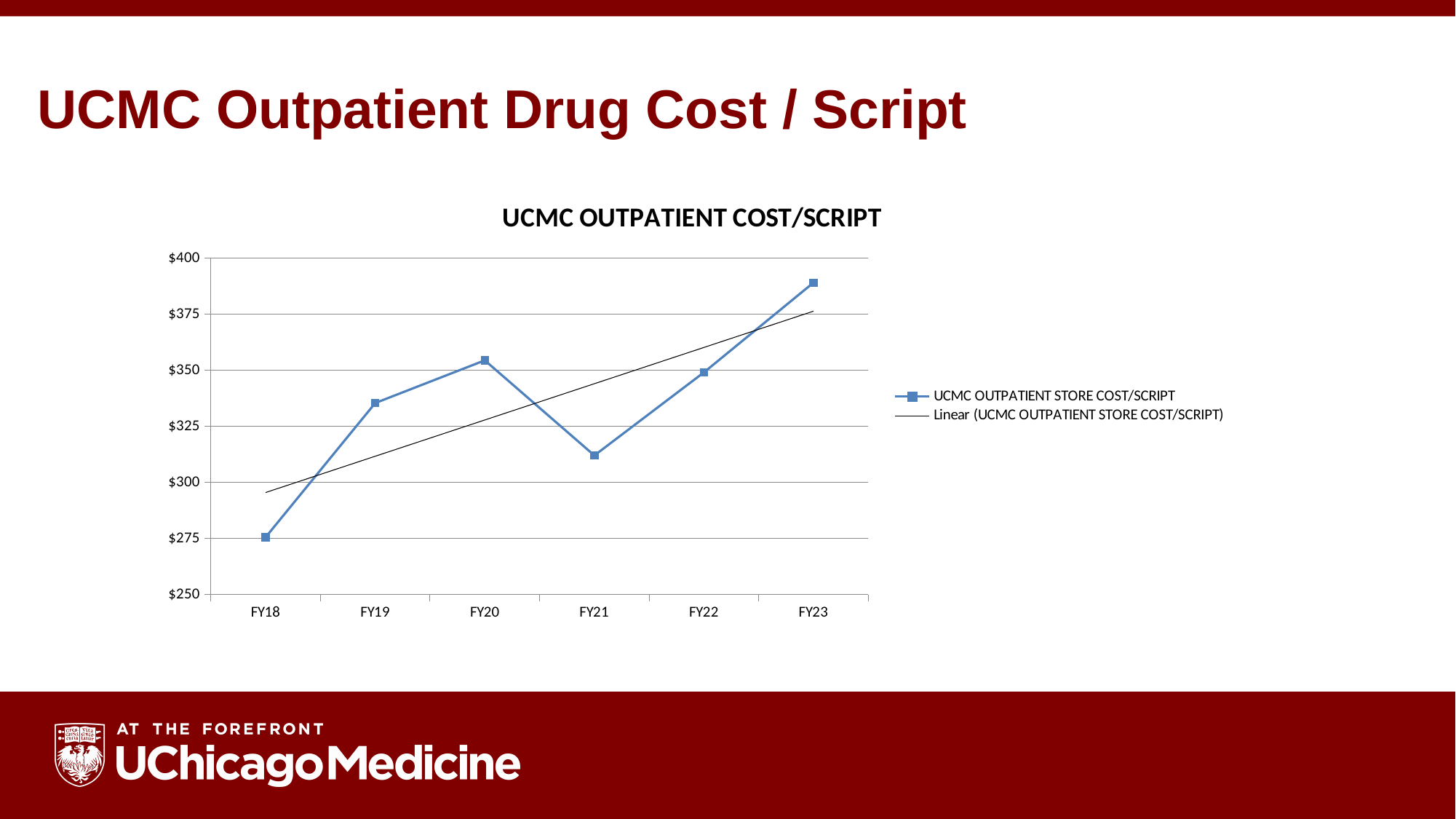
What is the title of the chart? UCMC OUTPATIENT COST/SCRIPT Which fiscal year has the highest UCMC outpatient store cost/script? FY23 How many fiscal years are plotted on the x axis? 6 Which fiscal year has the lowest UCMC outpatient store cost/script? FY18 What kind of chart is shown on the slide? line chart Is the cost/script for FY19 greater or less than $325? greater Is the cost/script for FY18 greater or less than $300? less Which fiscal year has a higher cost/script, FY19 or FY21? FY19 How many entries does the chart legend list? 2 Is the cost/script for FY23 greater or less than $375? greater Does the cost/script generally rise or fall from FY18 to FY23? rise